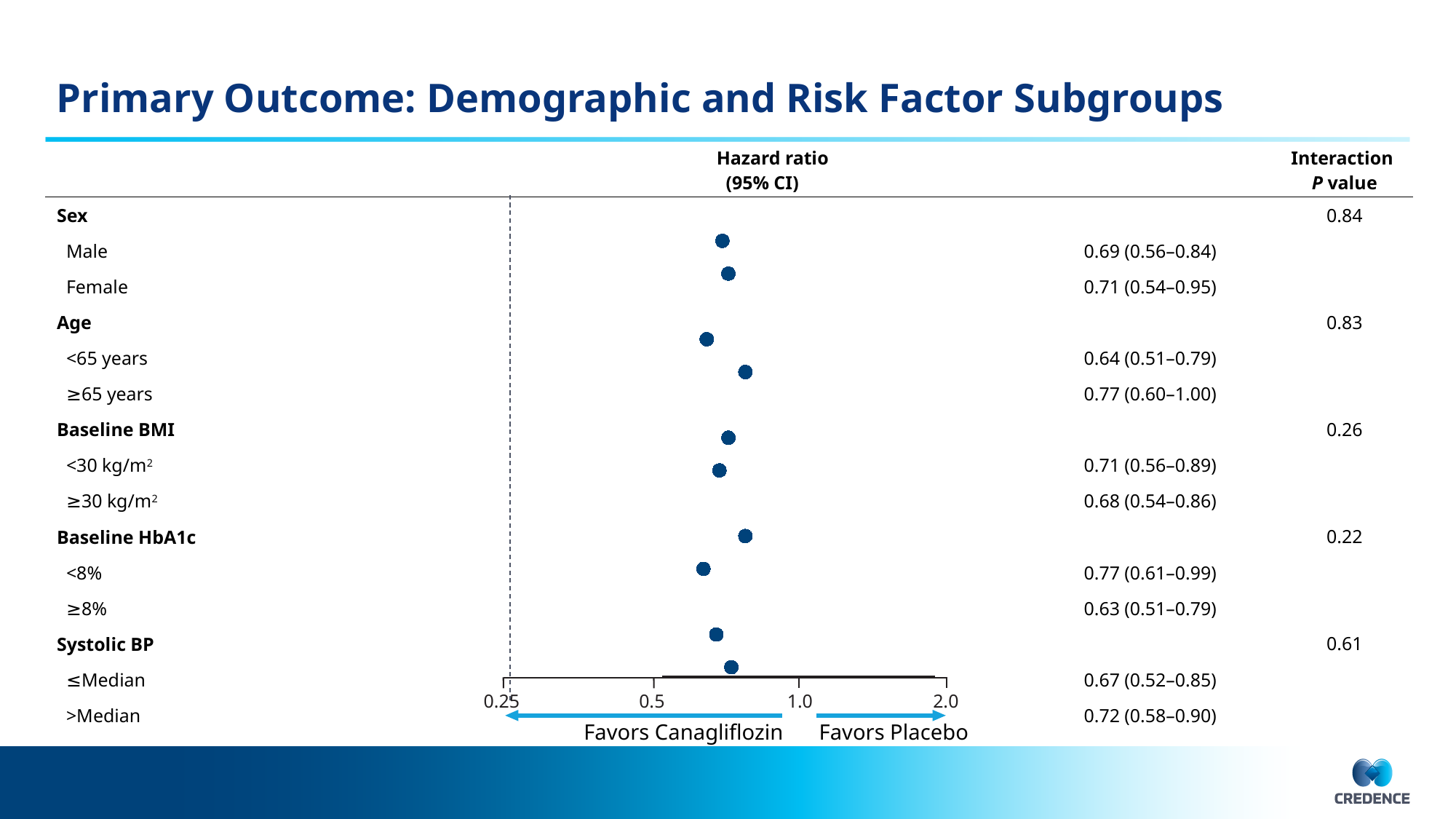
What is the interaction P value for Baseline BMI? 0.26 What is the interaction P value for Sex? 0.84 Which subgroup has the lowest hazard ratio point estimate? ≥8% (baseline HbA1c) What is the hazard ratio (95% CI) for the ≥8% baseline HbA1c subgroup? 0.63 (0.51–0.79) According to the axis labels, which side of the plot favors canagliflozin? Left (hazard ratios below 1.0) How many subgroup hazard ratios are plotted on the chart? 10 Which has the larger hazard ratio point estimate, the ≤Median or the >Median systolic BP subgroup? >Median Which subgroup has the lowest interaction P value? Baseline HbA1c What kind of chart is shown on the slide? Forest plot What is the hazard ratio (95% CI) for the ≥65 years subgroup? 0.77 (0.60–1.00) What is the hazard ratio (95% CI) for the Male subgroup? 0.69 (0.56–0.84) What is the difference between the hazard ratio point estimates for the <65 years and ≥65 years subgroups? 0.13